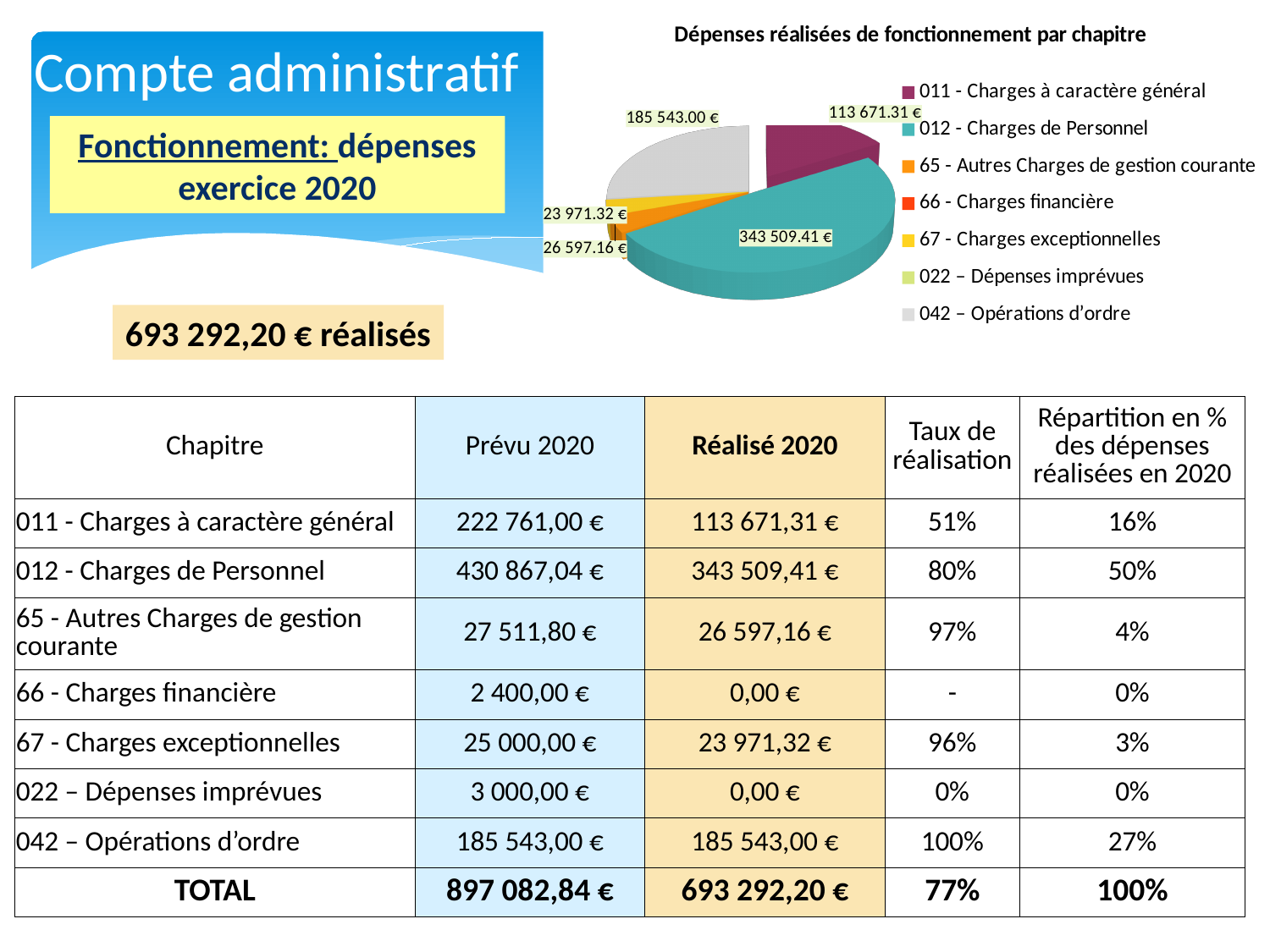
In the pie chart, what is the value shown for 65 - Autres Charges de gestion courante? 26 597.16 € What share of the pie does 012 - Charges de Personnel represent? 50% In the pie chart, what is the value shown for 012 - Charges de Personnel? 343 509.41 € In the pie chart, what is the value shown for 011 - Charges à caractère général? 113 671.31 € Which chapter has the largest slice in the pie chart? 012 - Charges de Personnel How many entries does the legend of the pie chart list? 7 What kind of chart is shown on the slide? pie chart What is the title of the pie chart? Dépenses réalisées de fonctionnement par chapitre What is the difference between the values for 012 - Charges de Personnel and 042 – Opérations d'ordre in the pie chart? 157 966.41 € In the pie chart, what is the value shown for 67 - Charges exceptionnelles? 23 971.32 € In the pie chart, what is the value shown for 042 – Opérations d'ordre? 185 543.00 € In the pie chart, which is larger: 042 – Opérations d'ordre or 011 - Charges à caractère général? 042 – Opérations d'ordre